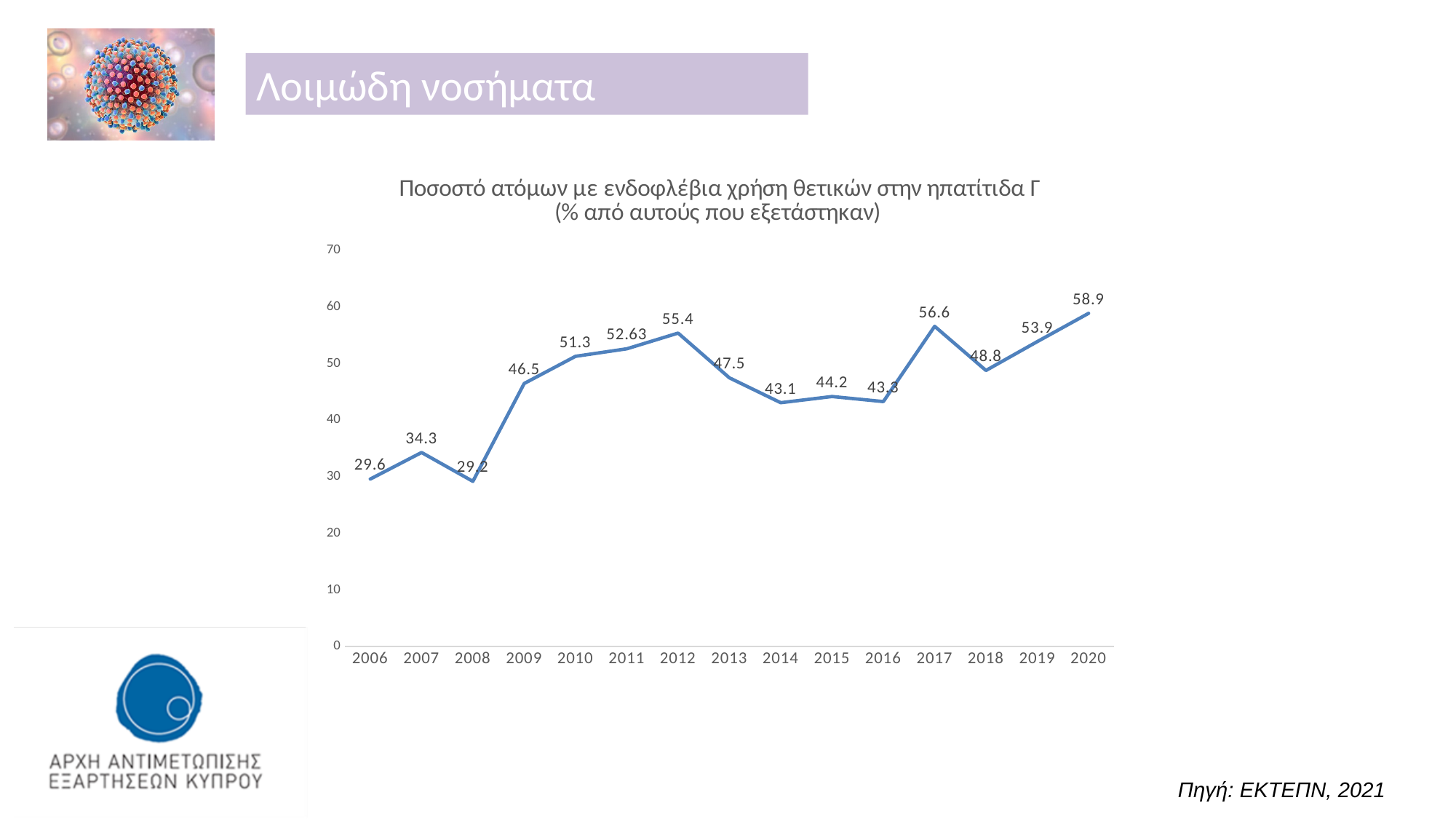
Is the value for 2014 greater or less than 50? less What is the difference between the values for 2020 and 2006? 29.3 What is the value for 2020? 58.9 How many years are plotted on the x axis? 15 What type of chart is shown on the slide? line chart What is the value for 2011? 52.63 What is the difference between the values for 2012 and 2013? 7.9 What is the value for 2009? 46.5 Which year has the lowest value? 2008 Which year has the highest value? 2020 Which is larger, the value for 2017 or the value for 2019? 2017 Does the value rise or fall from 2017 to 2018? fall